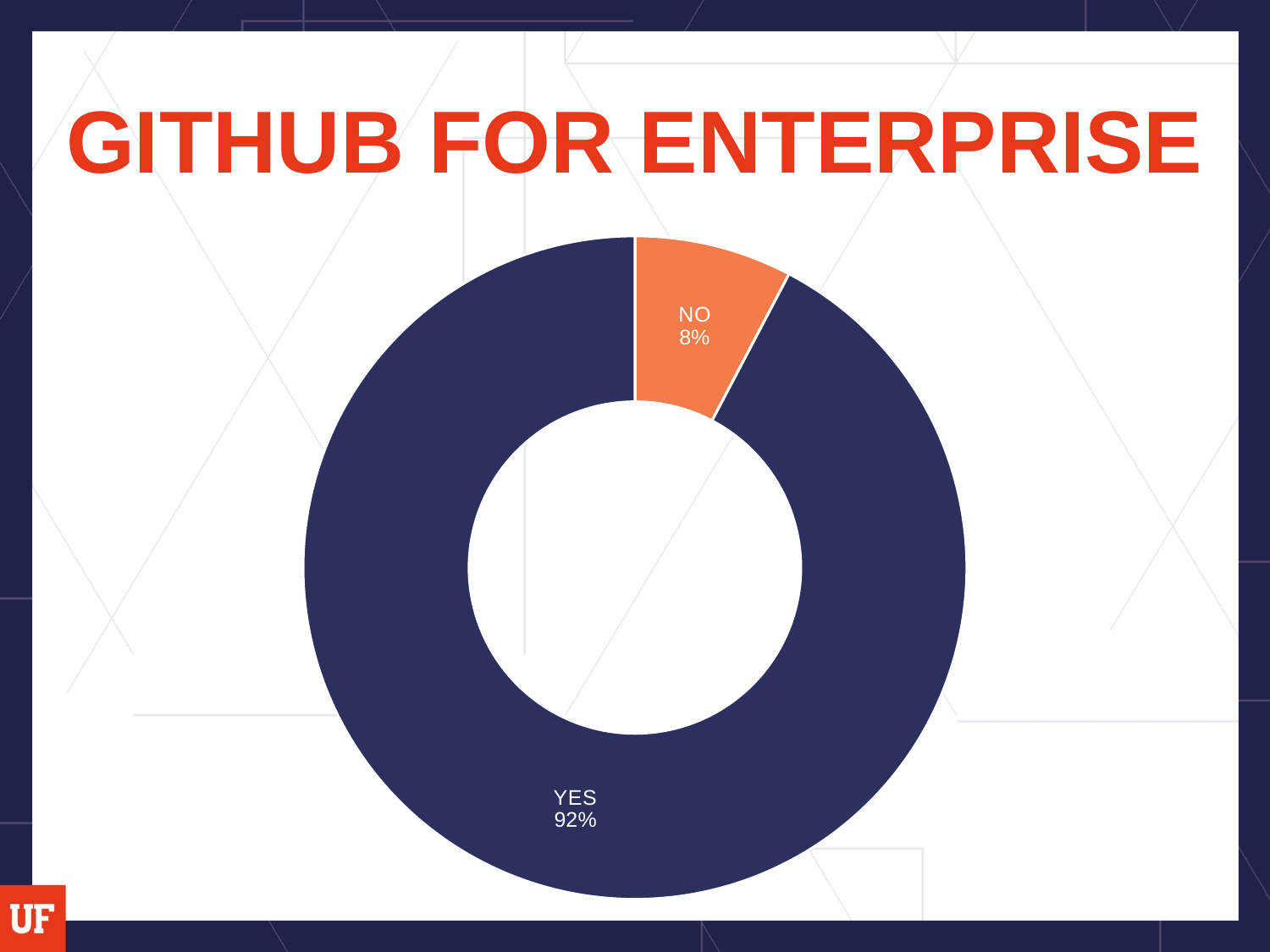
What percentage of responses are NO? 8% What percentage of responses are YES? 92% Which is larger, the YES share or the NO share? YES What is the difference in percentage points between YES and NO? 84 Which category has the smallest share of the chart? NO How many categories are shown in the chart? 2 What is the title of the slide? GITHUB FOR ENTERPRISE What colour is the NO slice? Orange What kind of chart is shown on the slide? Doughnut chart What share of the chart does the YES slice represent? 92% Which category has the largest share of the chart? YES